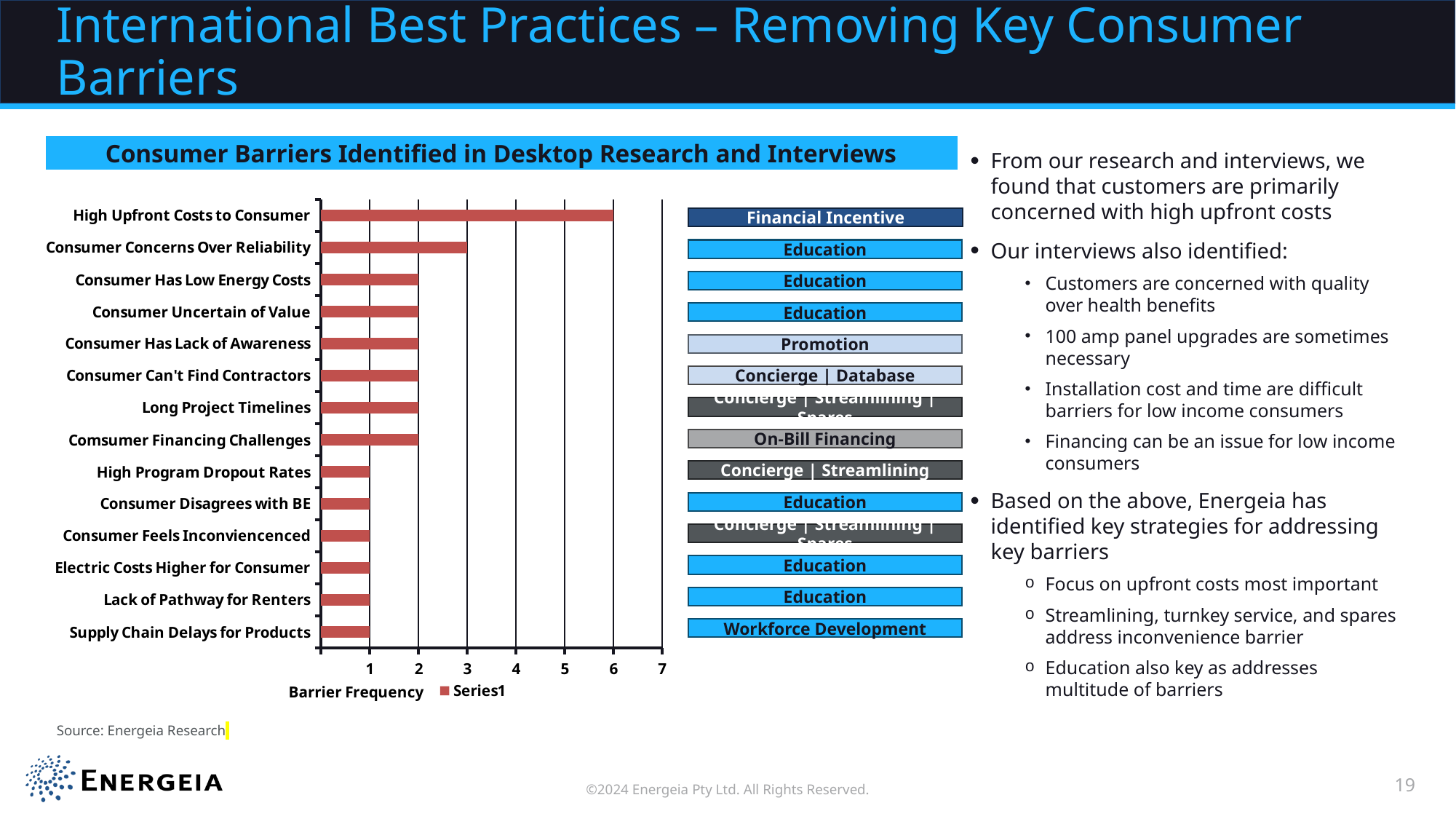
How many barriers are listed in the chart? 14 How many series does the chart legend list? 1 What is the barrier frequency for Lack of Pathway for Renters? 1 Is the barrier frequency for High Upfront Costs to Consumer greater or less than 5? greater What is the difference in barrier frequency between High Upfront Costs to Consumer and Consumer Concerns Over Reliability? 3 What is the barrier frequency for Consumer Concerns Over Reliability? 3 What is the barrier frequency for High Upfront Costs to Consumer? 6 Which has a higher barrier frequency, Consumer Uncertain of Value or High Program Dropout Rates? Consumer Uncertain of Value What type of chart is used to show the consumer barriers? Bar chart What is the barrier frequency for Long Project Timelines? 2 What is the title of the chart's horizontal axis? Barrier Frequency Which barrier has the highest frequency? High Upfront Costs to Consumer